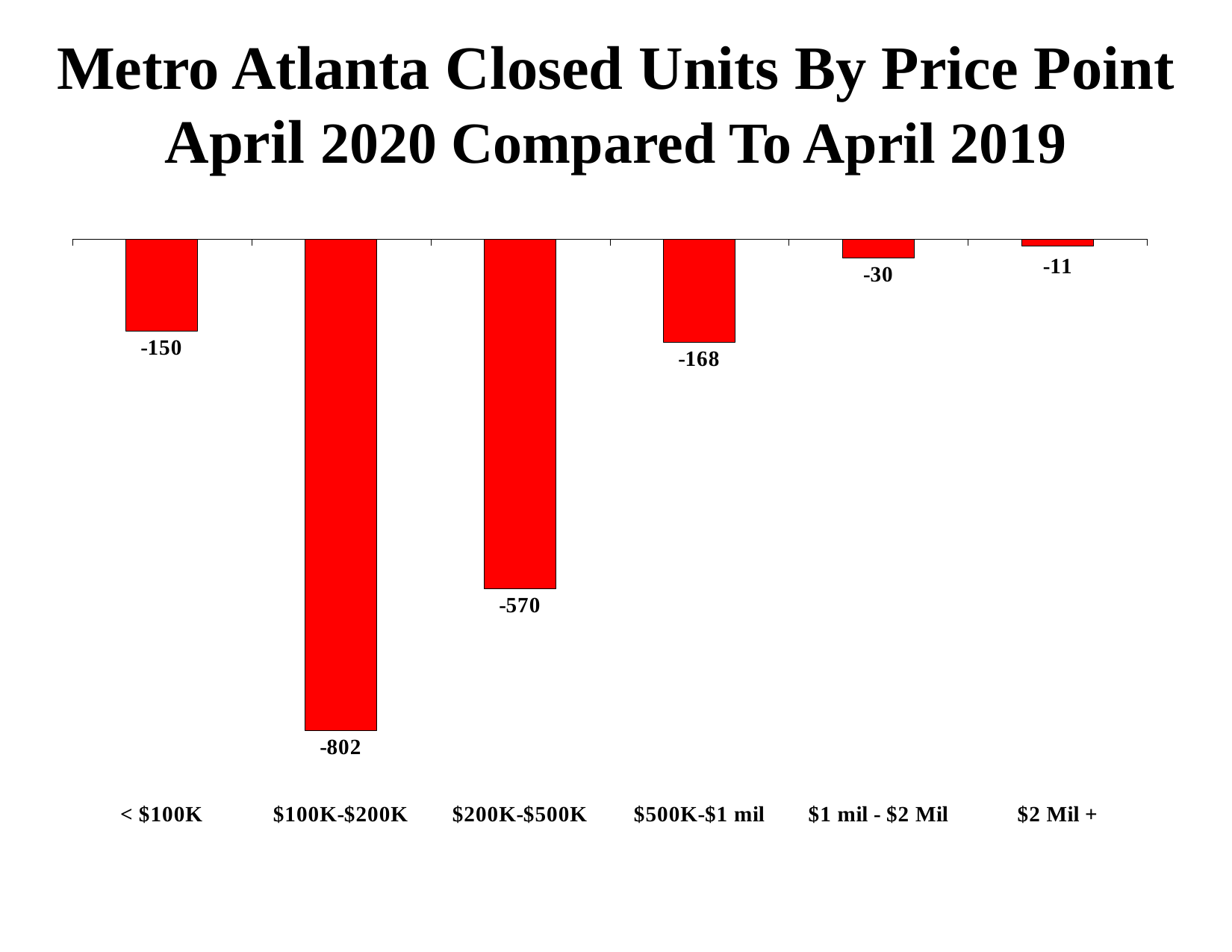
Which price point shows a larger decline, < $100K or $500K-$1 mil? $500K-$1 mil What is the value for the < $100K price point? -150 What kind of chart is shown on the slide? Bar chart Which price point has the largest decline in closed units? $100K-$200K Which price point has the smallest decline in closed units? $2 Mil + What is the value for the $500K-$1 mil price point? -168 What is the value for the $2 Mil + price point? -11 What colour are the bars in the chart? Red What is the difference between the values for $100K-$200K and $200K-$500K? 232 What is the value for the $100K-$200K price point? -802 What is the difference between the values for $1 mil - $2 Mil and $2 Mil +? 19 How many price point categories are shown in the chart? 6